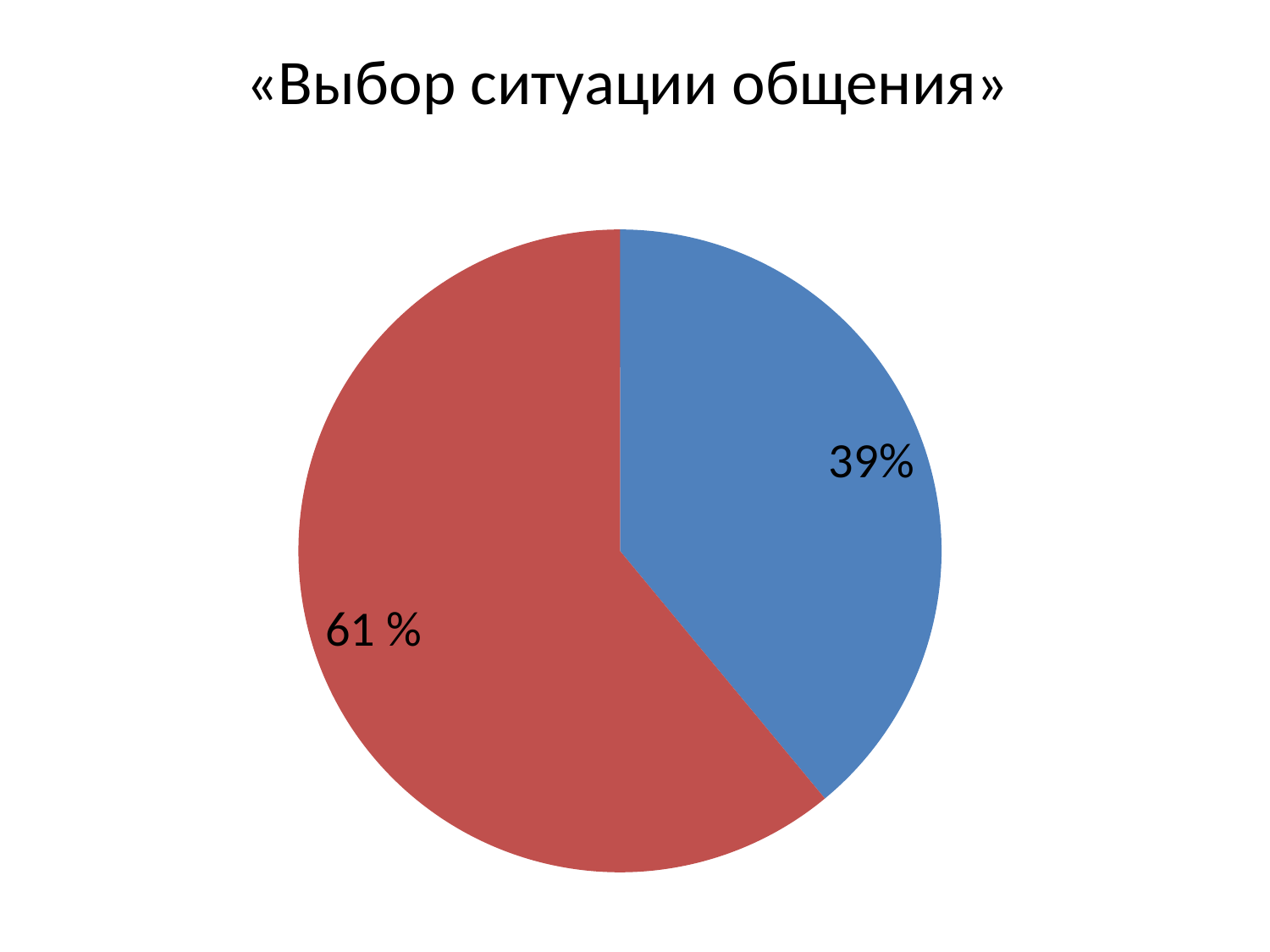
What share of the pie does the blue slice represent? 39% What share of the pie does the red slice represent? 61 % How many slices does the pie chart have? 2 What colours are used for the two slices of the pie chart? blue and red What is the difference in percentage points between the red slice and the blue slice? 22 percentage points What value is shown on the blue slice of the pie chart? 39% What is the title of the chart? «Выбор ситуации общения» Which slice of the pie chart is the largest? the red slice (61 %) Which is larger, the blue slice or the red slice? the red slice What value is shown on the red slice of the pie chart? 61 % What kind of chart is shown on the slide? pie chart Which slice of the pie chart is the smallest? the blue slice (39%)